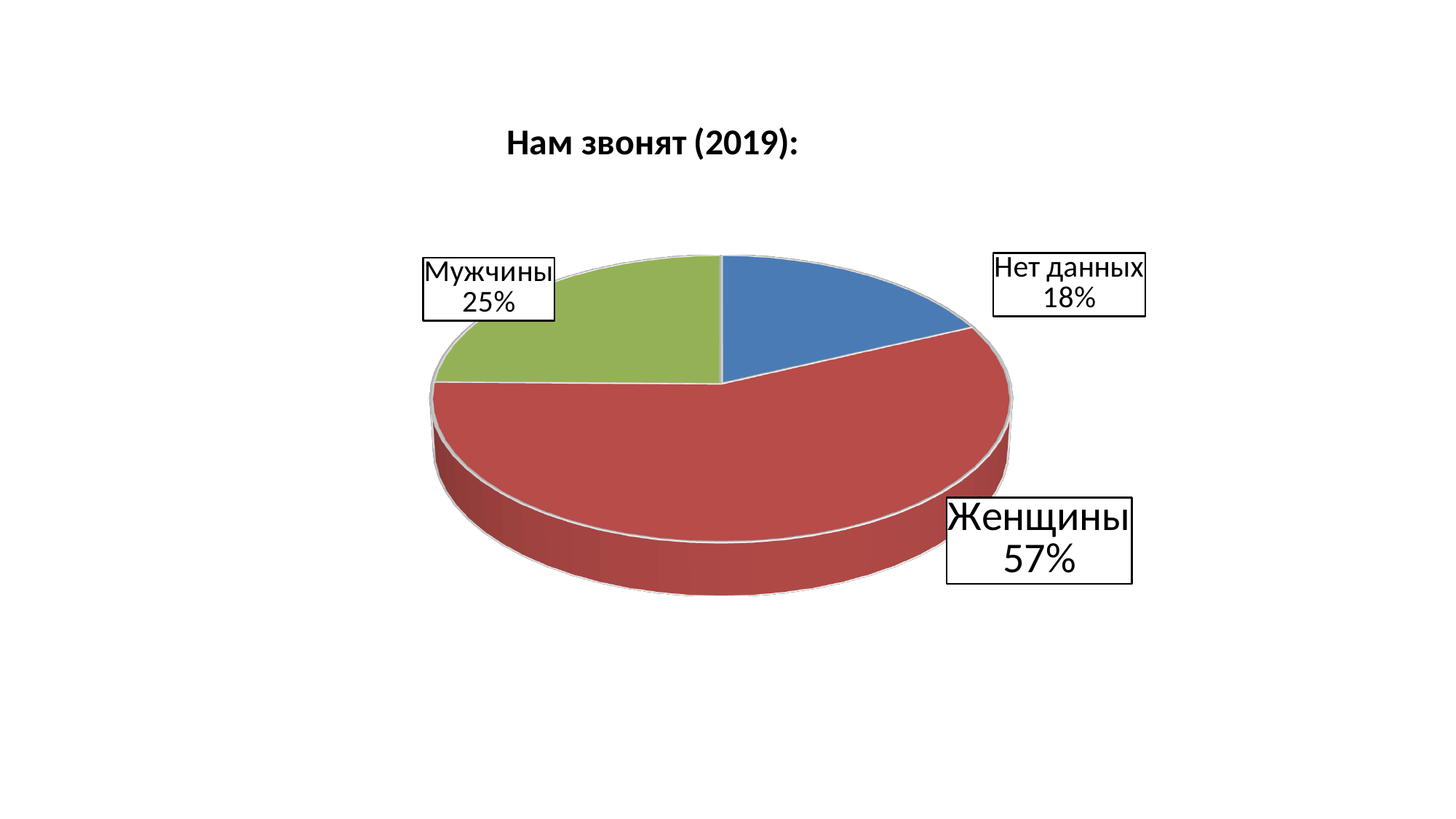
What share of the pie is labelled Женщины? 57% Which category has the largest slice of the pie? Женщины What is the difference in percentage points between the Мужчины and Нет данных slices? 7% What is the difference in percentage points between the Женщины and Мужчины slices? 32% What kind of chart is shown on the slide? Pie chart How many slices does the pie chart have? 3 What colour is the Женщины slice? Red What share of the pie is labelled Мужчины? 25% What share of the pie is labelled Нет данных? 18% What is the title of the chart? Нам звонят (2019): Which slice is larger, Мужчины or Нет данных? Мужчины Which category has the smallest slice of the pie? Нет данных